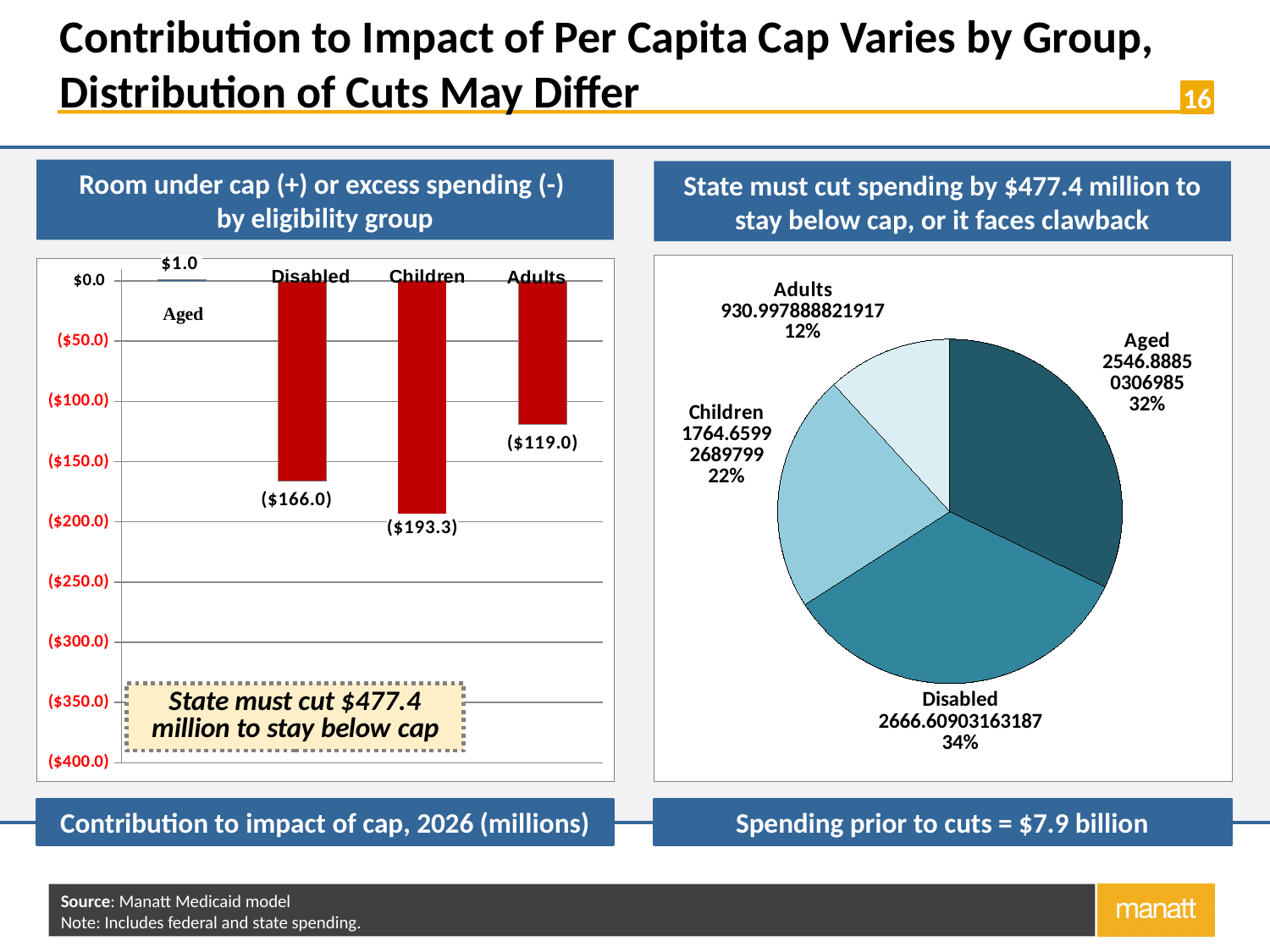
In the pie chart on the right, what share of spending is attributed to Adults? 12% In the bar chart on the left, what is the value for Children? ($193.3) In the bar chart on the left, what is the value for Adults? ($119.0) In the bar chart on the left, what is the value for Aged? $1.0 In the bar chart on the left, which eligibility group has the largest excess spending (most negative value)? Children In the bar chart on the left, how many eligibility groups are shown? 4 In the bar chart on the left, what is the difference between the Disabled value and the Adults value? $47.0 In the pie chart on the right, is the Aged slice larger or smaller than the Children slice? Larger In the bar chart on the left, which eligibility group has the highest value? Aged In the pie chart on the right, which group has the smallest slice? Adults In the pie chart on the right, what share of spending is attributed to Disabled? 34% What kind of chart is shown on the left side of the slide? Bar chart